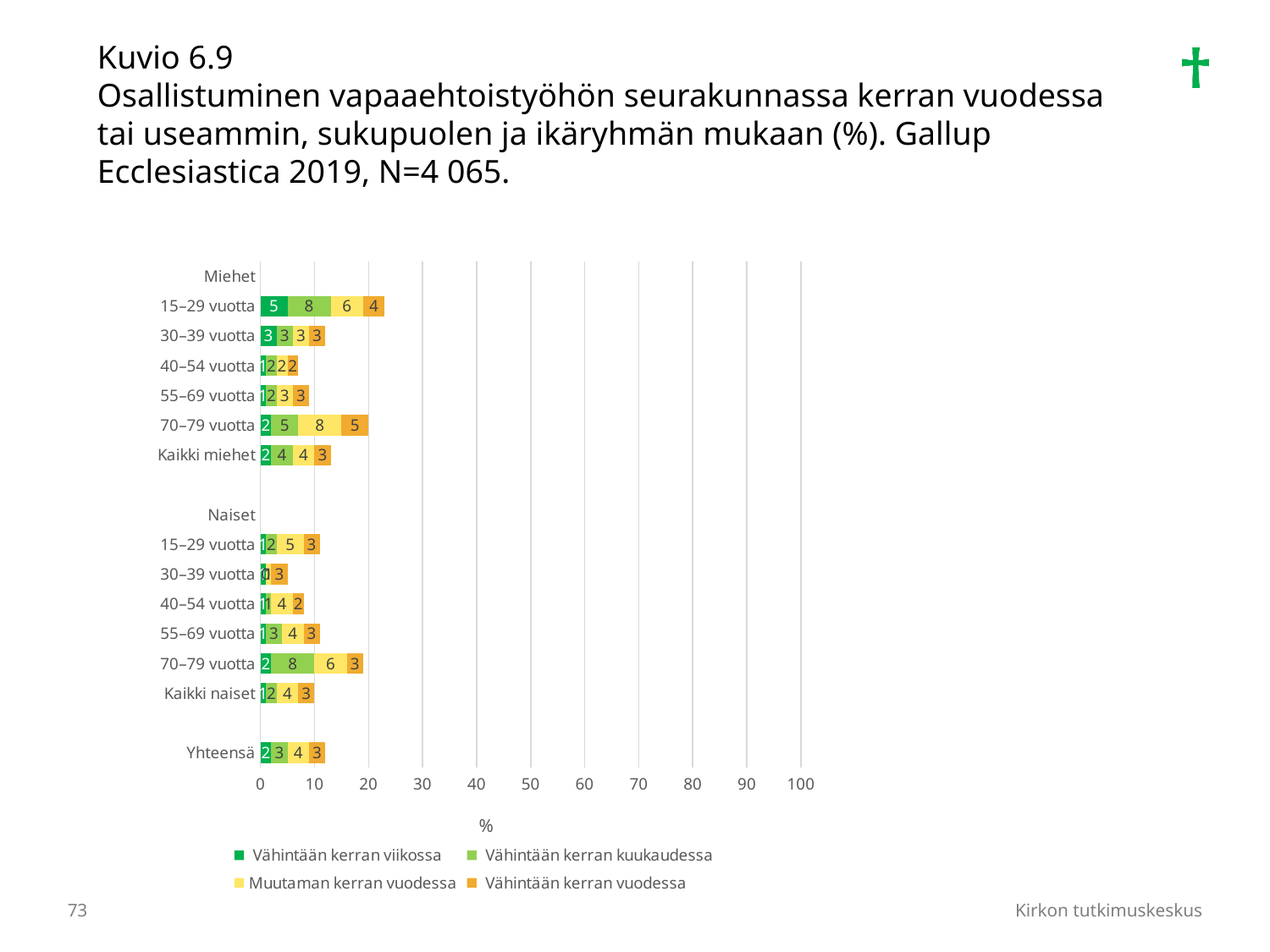
What is the value of 'Vähintään kerran vuodessa' for Yhteensä? 3 What is the difference between the 'Vähintään kerran vuodessa' values for men aged 70–79 vuotta (5) and women aged 70–79 vuotta (3)? 2 What is the value of 'Vähintään kerran kuukaudessa' for women (Naiset) aged 70–79 vuotta? 8 What is the value of 'Muutaman kerran vuodessa' for men (Miehet) aged 70–79 vuotta? 8 What is the value of 'Vähintään kerran kuukaudessa' for men (Miehet) aged 15–29 vuotta? 8 What is the total of the stacked bar for Kaikki miehet? 13 How many series does the legend list? 4 What is the total of the stacked bar for men (Miehet) aged 15–29 vuotta? 23 What kind of chart is shown on the slide? Stacked bar chart What is the value of 'Vähintään kerran viikossa' for men (Miehet) aged 15–29 vuotta? 5 Which group has the longest stacked bar overall? Miehet 15–29 vuotta Is the total bar for women (Naiset) aged 70–79 vuotta greater or less than 20? less